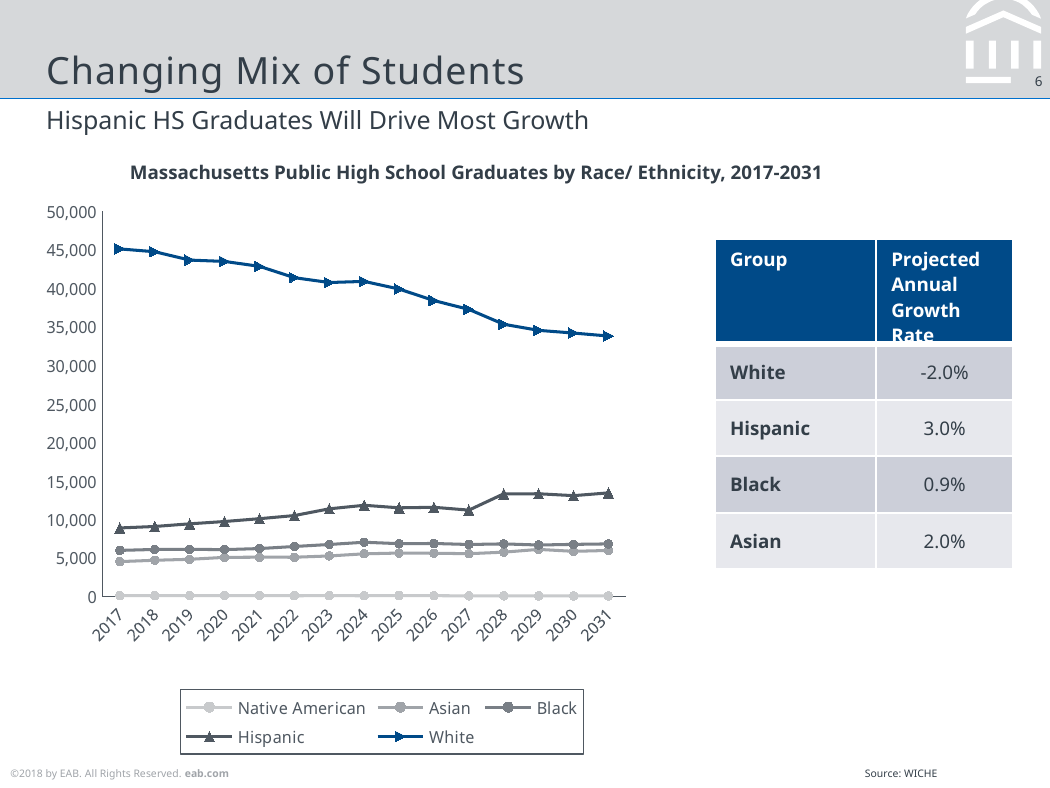
Which series has the lowest values across the chart? Native American Does the Hispanic series rise or fall from 2017 to 2031? Rise Does the White series rise or fall from 2017 to 2031? Fall How many years are plotted along the x axis of the chart? 15 Is the value for White in 2017 greater or less than 40,000? greater What kind of chart is shown on the slide? Line chart What is the title of the chart? Massachusetts Public High School Graduates by Race/ Ethnicity, 2017-2031 Is the value for White in 2031 greater or less than 35,000? less In 2031, which is larger, the Hispanic value or the Black value? Hispanic Is the value for Hispanic in 2031 greater or less than 10,000? greater How many series does the chart's legend list? 5 Which series has the highest values across the chart? White